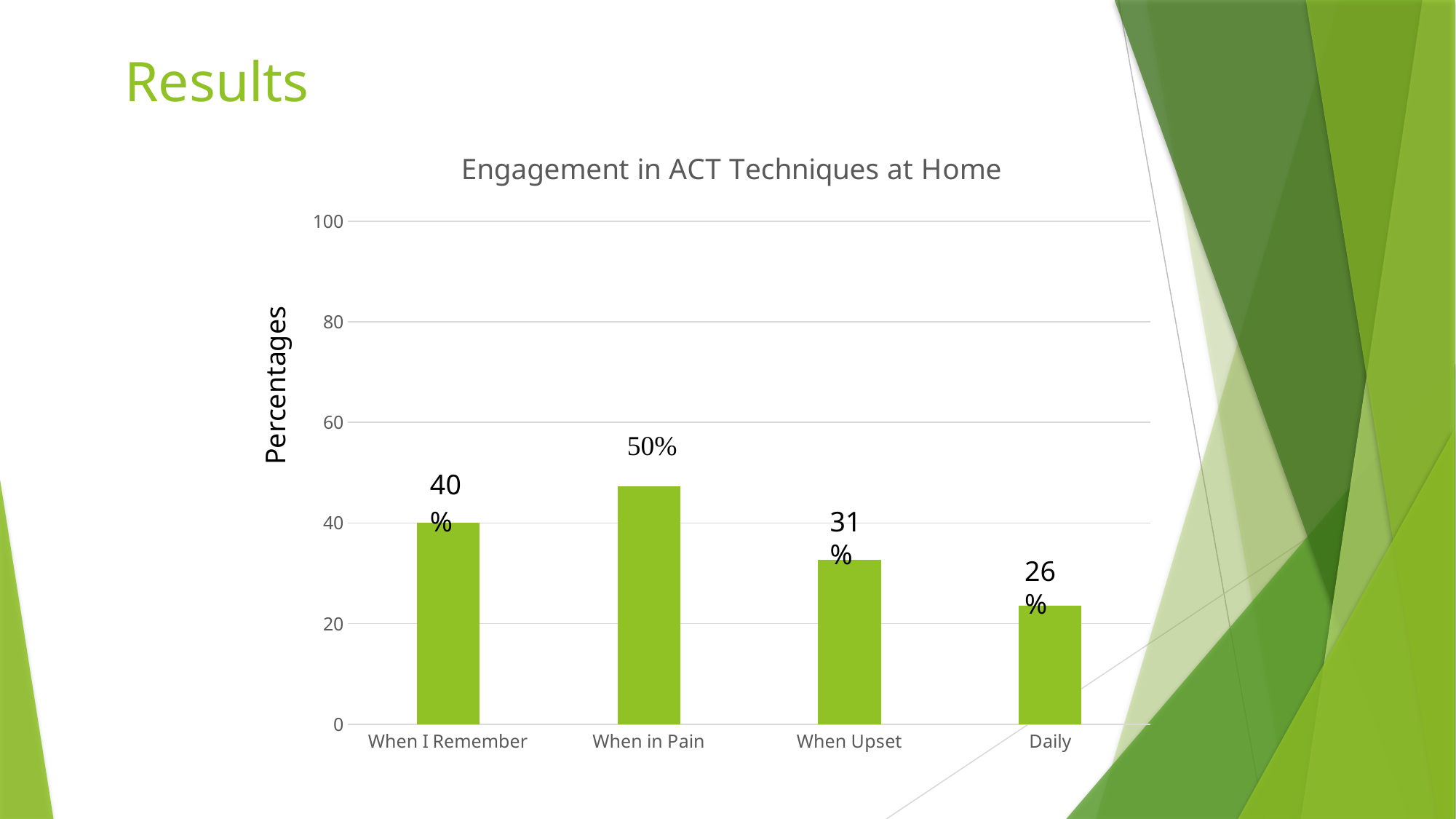
Which category has the lowest value? Daily Is the value for When in Pain greater or less than 60? less Which is larger, the value for When I Remember or the value for When Upset? When I Remember What is the value for When in Pain? 50% What is the title of the chart? Engagement in ACT Techniques at Home How many categories are shown on the x axis? 4 What kind of chart is shown on the slide? bar chart What is the value for When I Remember? 40% What is the value for Daily? 26% What is the difference between the values for When in Pain and Daily? 24% Which category has the highest value? When in Pain What is the value for When Upset? 31%